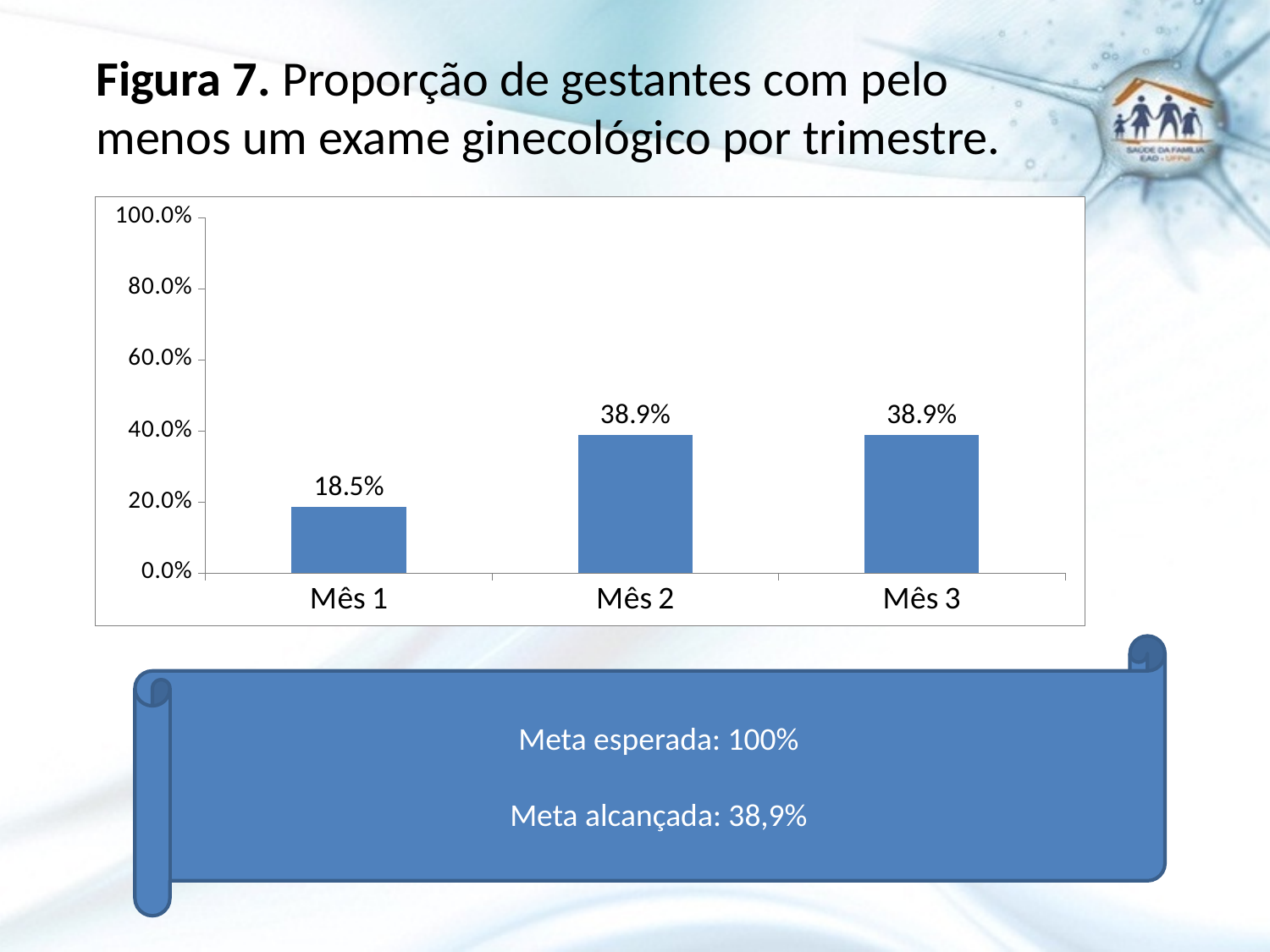
What is the difference between the values for Mês 2 and Mês 1? 20.4% What is the highest value shown on the y axis? 100.0% Which is larger, the value for Mês 1 or the value for Mês 3? Mês 3 How many months are shown on the x axis? 3 Which month has the lowest value? Mês 1 Is the value for Mês 2 greater or less than 40.0%? less What is the value for Mês 1? 18.5% What kind of chart is shown on the slide? bar chart What is the value for Mês 2? 38.9% Is the value for Mês 1 greater or less than 20.0%? less Do the values rise or fall from Mês 1 to Mês 2? rise What is the value for Mês 3? 38.9%